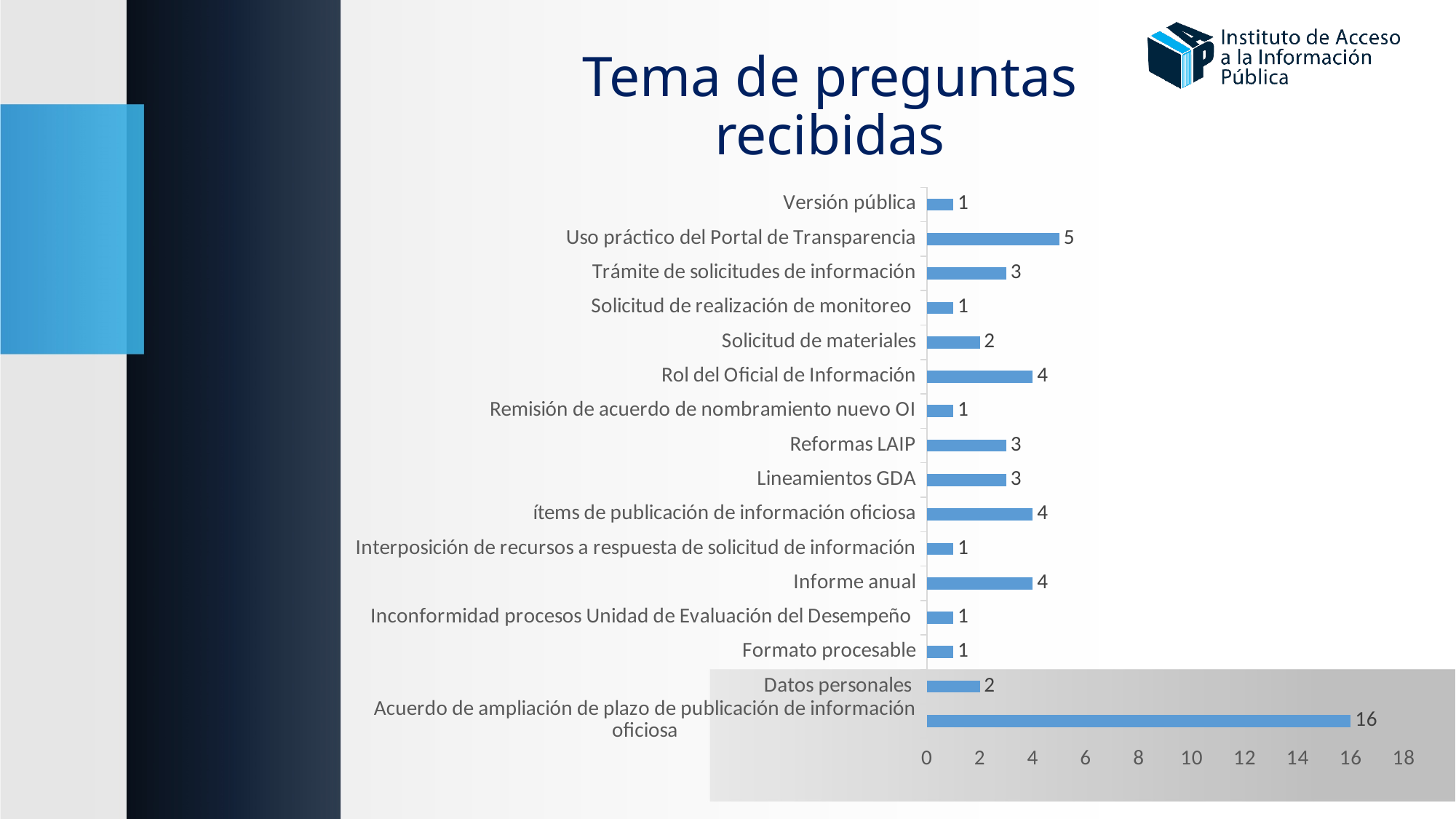
What is the difference between the values for "Acuerdo de ampliación de plazo de publicación de información oficiosa" and "Uso práctico del Portal de Transparencia"? 11 How many categories are shown in the chart? 16 What is the title of the chart? Tema de preguntas recibidas Which is larger, the value for "Trámite de solicitudes de información" or the value for "Versión pública"? Trámite de solicitudes de información Which category has the highest value? Acuerdo de ampliación de plazo de publicación de información oficiosa What is the value for "Rol del Oficial de Información"? 4 What is the value for "Datos personales"? 2 What kind of chart is shown on the slide? bar chart What is the difference between the values for "Informe anual" and "Solicitud de materiales"? 2 Is the value for "Acuerdo de ampliación de plazo de publicación de información oficiosa" greater or less than 10? greater What is the value for "Acuerdo de ampliación de plazo de publicación de información oficiosa"? 16 What is the value for "Uso práctico del Portal de Transparencia"? 5